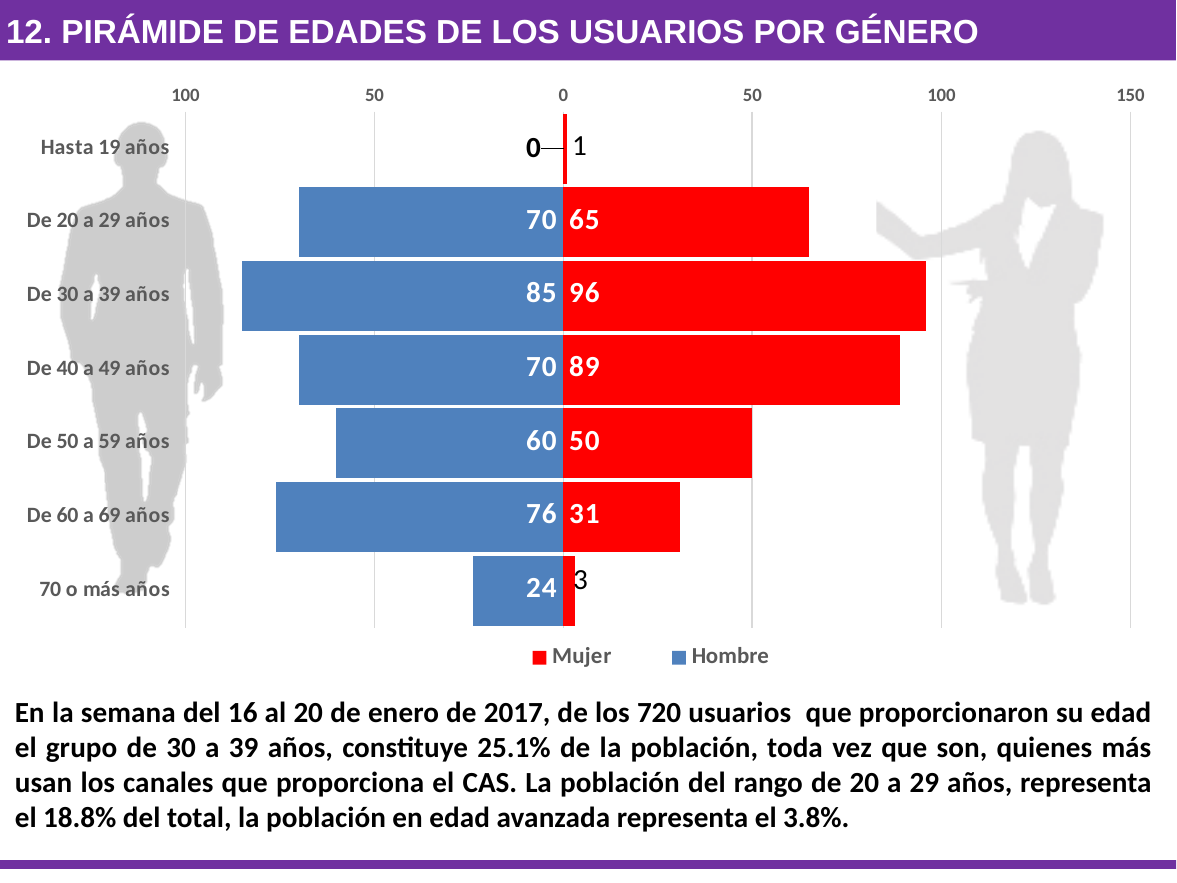
What is the total of the Hombre and Mujer values for the 'De 50 a 59 años' age group? 110 What is the Mujer value for the 'De 30 a 39 años' age group? 96 What kind of chart is shown on the slide? Bar chart What is the difference between the Mujer and Hombre values for the 'De 40 a 49 años' age group? 19 How many age groups are shown on the chart? 7 Which colour represents the Mujer series in the chart? Red How many series does the legend list? 2 What is the Hombre value for the 'De 60 a 69 años' age group? 76 For the 'De 60 a 69 años' age group, which is larger, the Hombre value or the Mujer value? Hombre Which age group has the lowest Hombre value? Hasta 19 años Which age group has the highest Mujer value? De 30 a 39 años What is the Mujer value for the '70 o más años' age group? 3